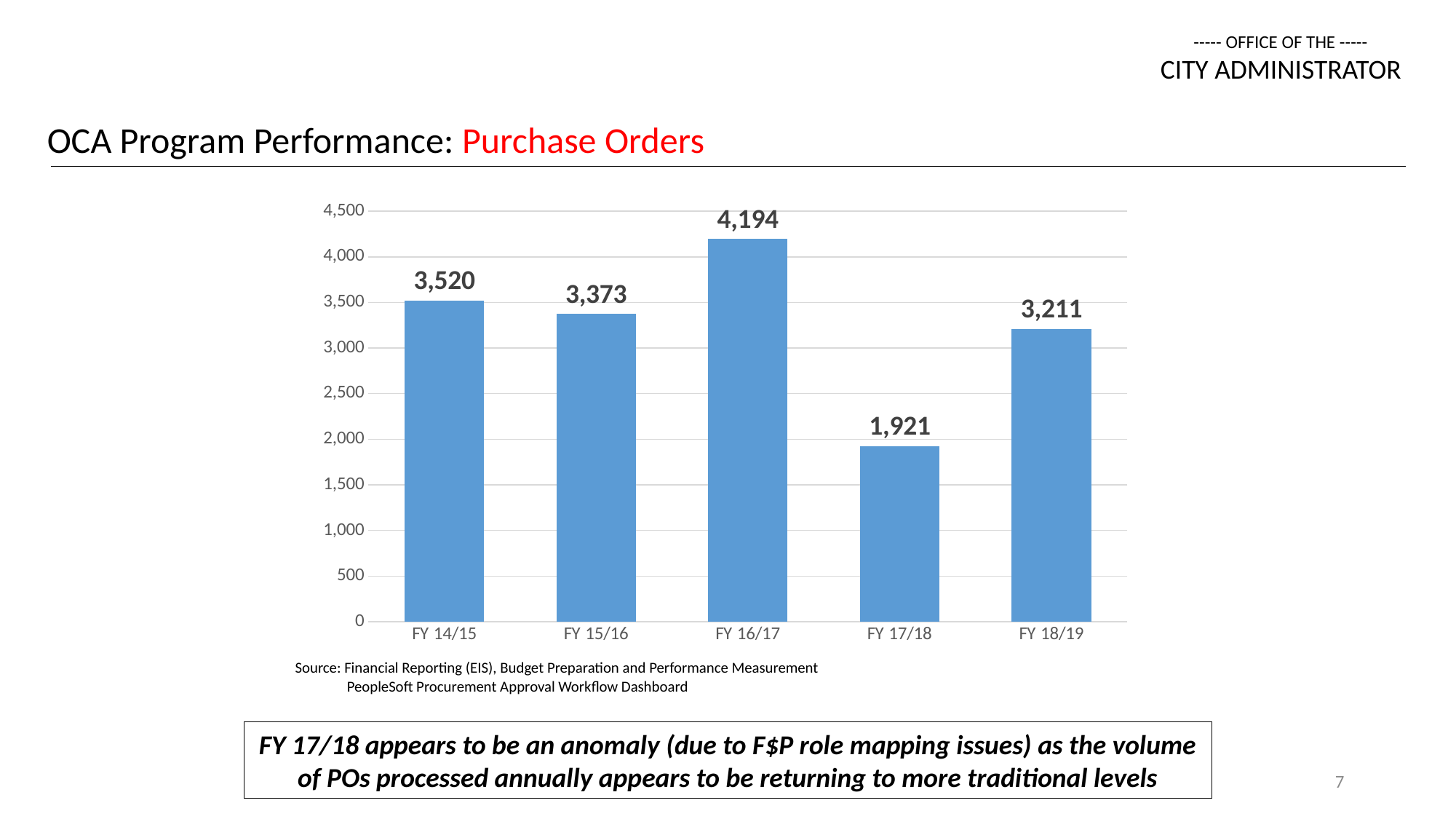
What is the value for FY 16/17? 4,194 What is the difference between the values for FY 16/17 and FY 17/18? 2,273 What kind of chart is shown on the slide? bar chart Is the value for FY 17/18 greater or less than 2,000? less Does the value rise or fall from FY 17/18 to FY 18/19? rise What is the difference between the values for FY 14/15 and FY 15/16? 147 What is the value for FY 17/18? 1,921 Which is larger, the value for FY 14/15 or the value for FY 18/19? FY 14/15 How many fiscal years are shown on the chart? 5 Which fiscal year has the lowest value? FY 17/18 What is the value for FY 18/19? 3,211 Which fiscal year has the highest value? FY 16/17